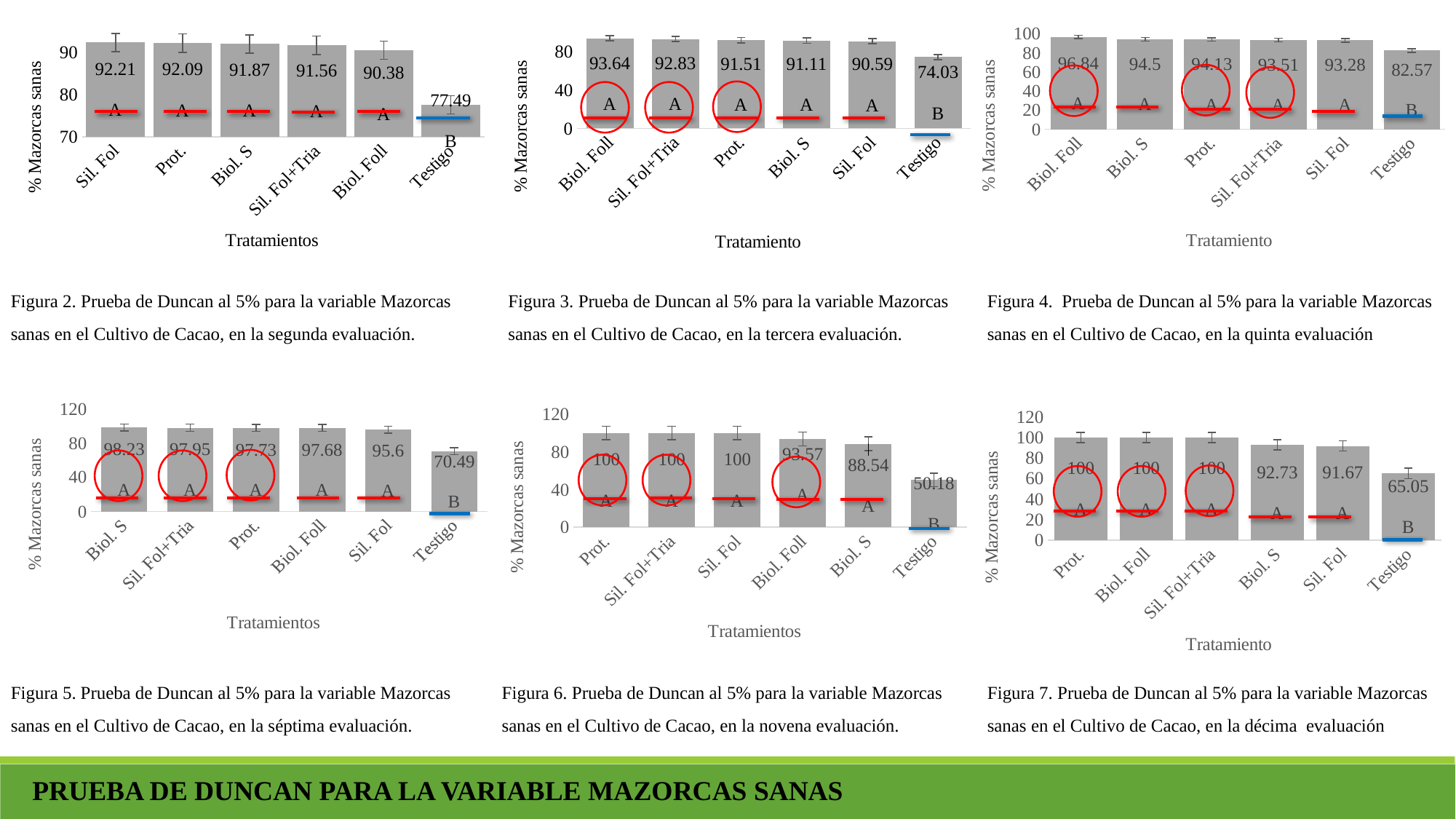
In the Figura 2 chart (top-left), which treatment has the lowest value? Testigo In the Figura 5 chart (bottom-left), what is the value for Sil. Fol? 95.6 In the Figura 4 chart (top-right), how many treatments are shown on the x axis? 6 In the Figura 6 chart (bottom-middle), what is the value for Biol. S? 88.54 In the Figura 3 chart (top-middle), which treatment has the highest value? Biol. Foll In the Figura 3 chart (top-middle), what is the value for Testigo? 74.03 In the Figura 4 chart (top-right), what is the difference between the values for Biol. Foll and Testigo? 14.27 In the Figura 5 chart (bottom-left), which is larger, the value for Biol. S or the value for Testigo? Biol. S In the Figura 7 chart (bottom-right), what is the value for Testigo? 65.05 In the Figura 2 chart (top-left), what is the value for Sil. Fol? 92.21 In the Figura 6 chart (bottom-middle), what is the difference between the values for Prot. and Testigo? 49.82 What kind of chart is the Figura 7 chart (bottom-right)? Bar chart